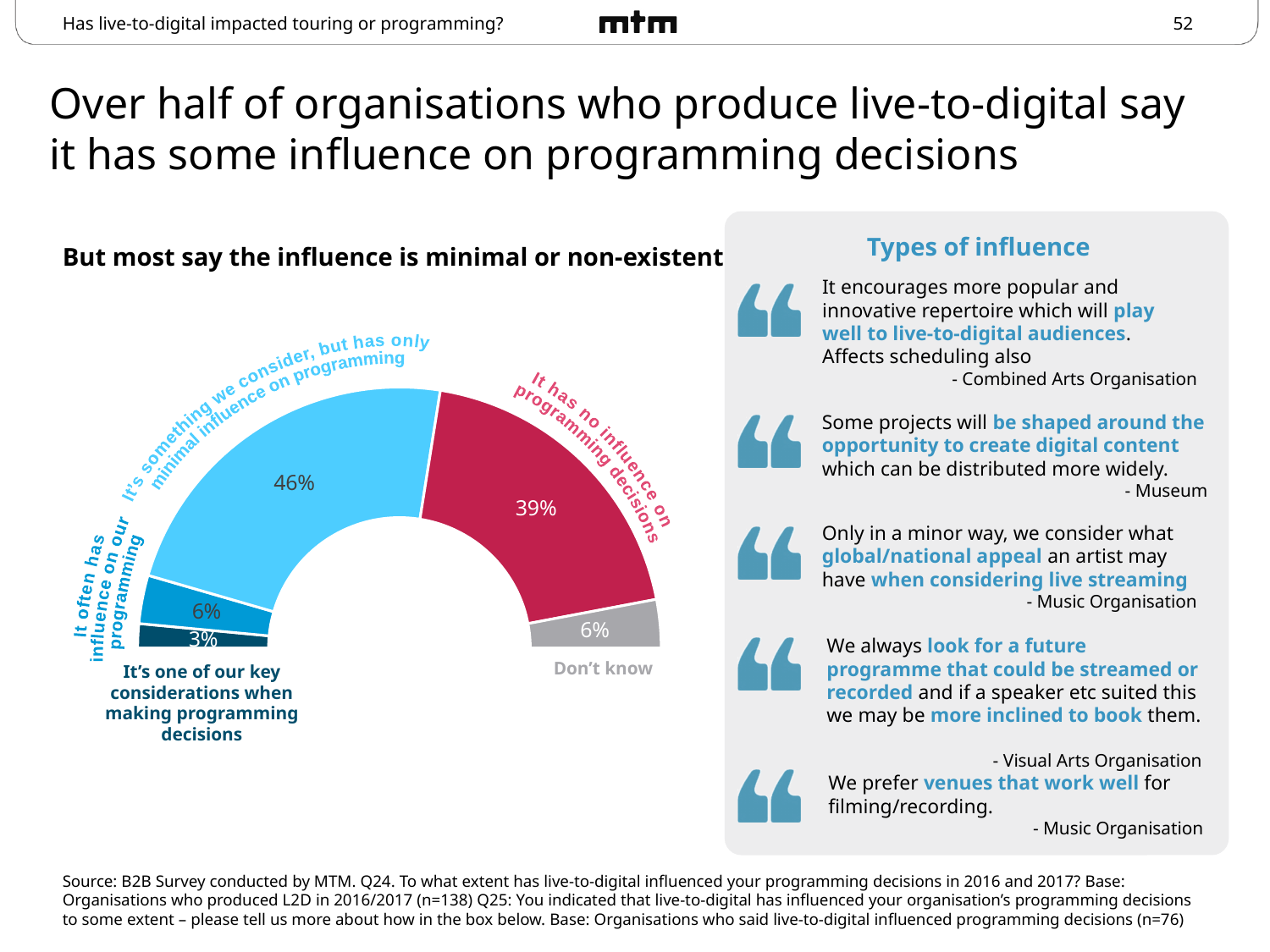
What is the combined share of organisations saying live-to-digital often has influence or is one of their key considerations? 9% What percentage of organisations say live-to-digital is one of their key considerations when making programming decisions? 3% How many response categories are shown in the chart? 5 What percentage of organisations say live-to-digital is something they consider but has only minimal influence on programming? 46% What percentage of organisations answered 'Don't know'? 6% Which response has the largest share in the chart? It's something we consider, but has only minimal influence on programming Which is larger: the share saying it often has influence on programming, or the share saying it has no influence on programming decisions? It has no influence on programming decisions What percentage of organisations say live-to-digital has no influence on programming decisions? 39% Which response has the smallest share in the chart? It's one of our key considerations when making programming decisions What is the heading of the grey box to the right of the chart? Types of influence What type of chart is used to show the survey responses? Doughnut chart (semi-circle) What is the difference between the share saying minimal influence and the share saying no influence? 7%